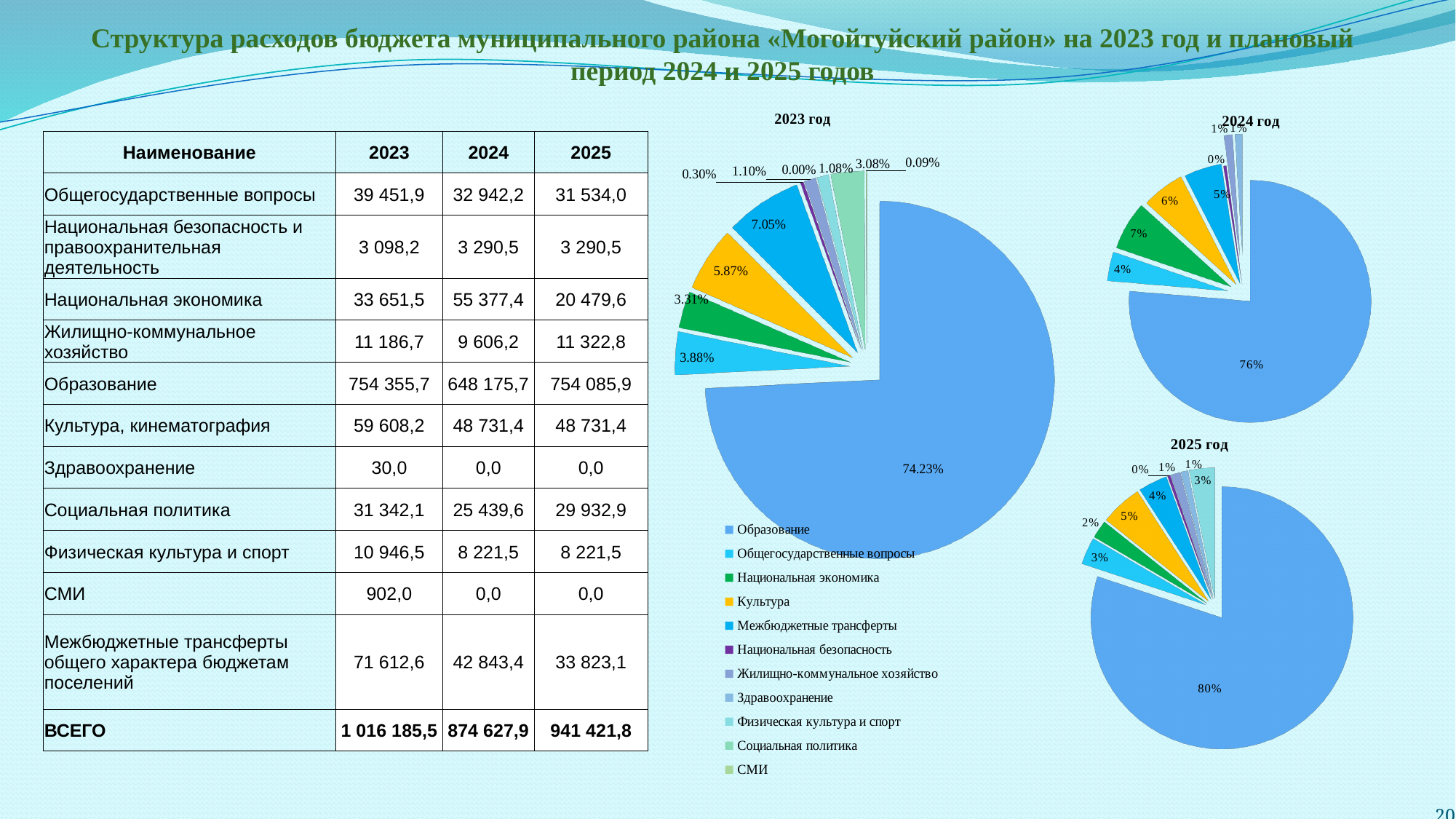
How many pie charts are shown on the slide? 3 In the 2023 год pie chart, what share does Культура have? 5.87% In the 2023 год pie chart, which is larger: the share of Культура or the share of Национальная экономика? Культура In the 2023 год pie chart, what share does Образование have? 74.23% What kind of chart is used to show the 2023 год budget structure? pie chart How many entries does the shared legend of the pie charts list? 11 In the 2024 год pie chart, what share does Образование have? 76% In the 2023 год pie chart, which category has the largest share? Образование In the 2025 год pie chart, what share does Образование have? 80% Across the 2023, 2024 and 2025 pie charts, does the share of Образование rise or fall? rise In the 2023 год pie chart, what share does Межбюджетные трансферты have? 7.05% In the 2023 год pie chart, what is the difference between the shares of Образование and Межбюджетные трансферты? 67.18%